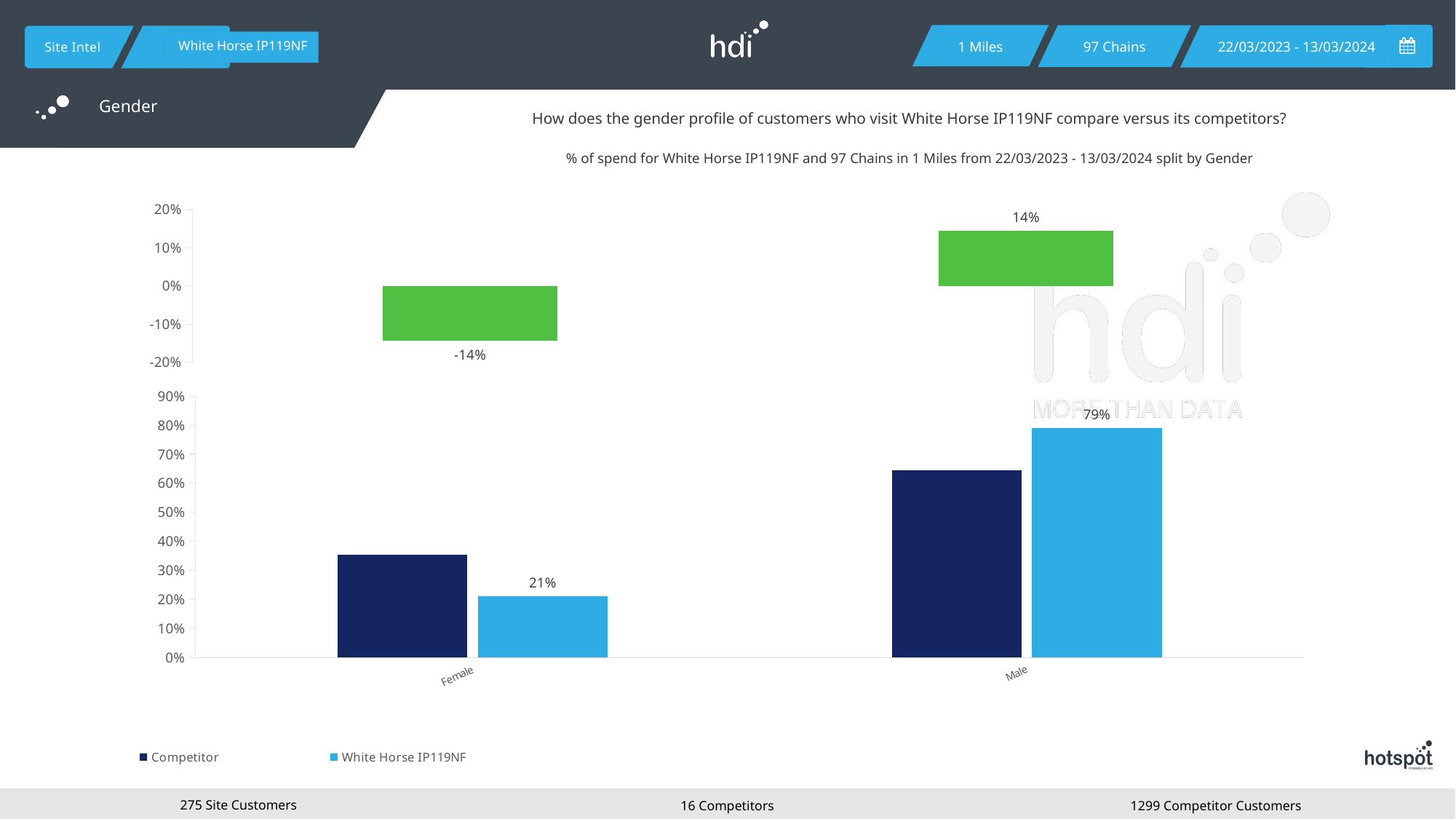
In the top chart, what is the value shown for Female? -14% In the bottom chart, what is the difference between the White Horse IP119NF values for Male and Female? 58% What kind of chart is the bottom chart? Bar chart In the bottom chart, is the Competitor value for Male greater or less than 70%? less In the bottom chart, what is the value for White Horse IP119NF for Female? 21% In the bottom chart, is the Competitor value for Female greater or less than 30%? greater In the bottom chart, for Female, which is larger: the Competitor value or the White Horse IP119NF value? Competitor In the bottom chart, which gender category has the higher value for White Horse IP119NF? Male In the bottom chart, for Male, which is larger: the Competitor value or the White Horse IP119NF value? White Horse IP119NF In the top chart, what is the value shown for Male? 14% How many series does the legend of the bottom chart list? 2 In the bottom chart, what is the value for White Horse IP119NF for Male? 79%